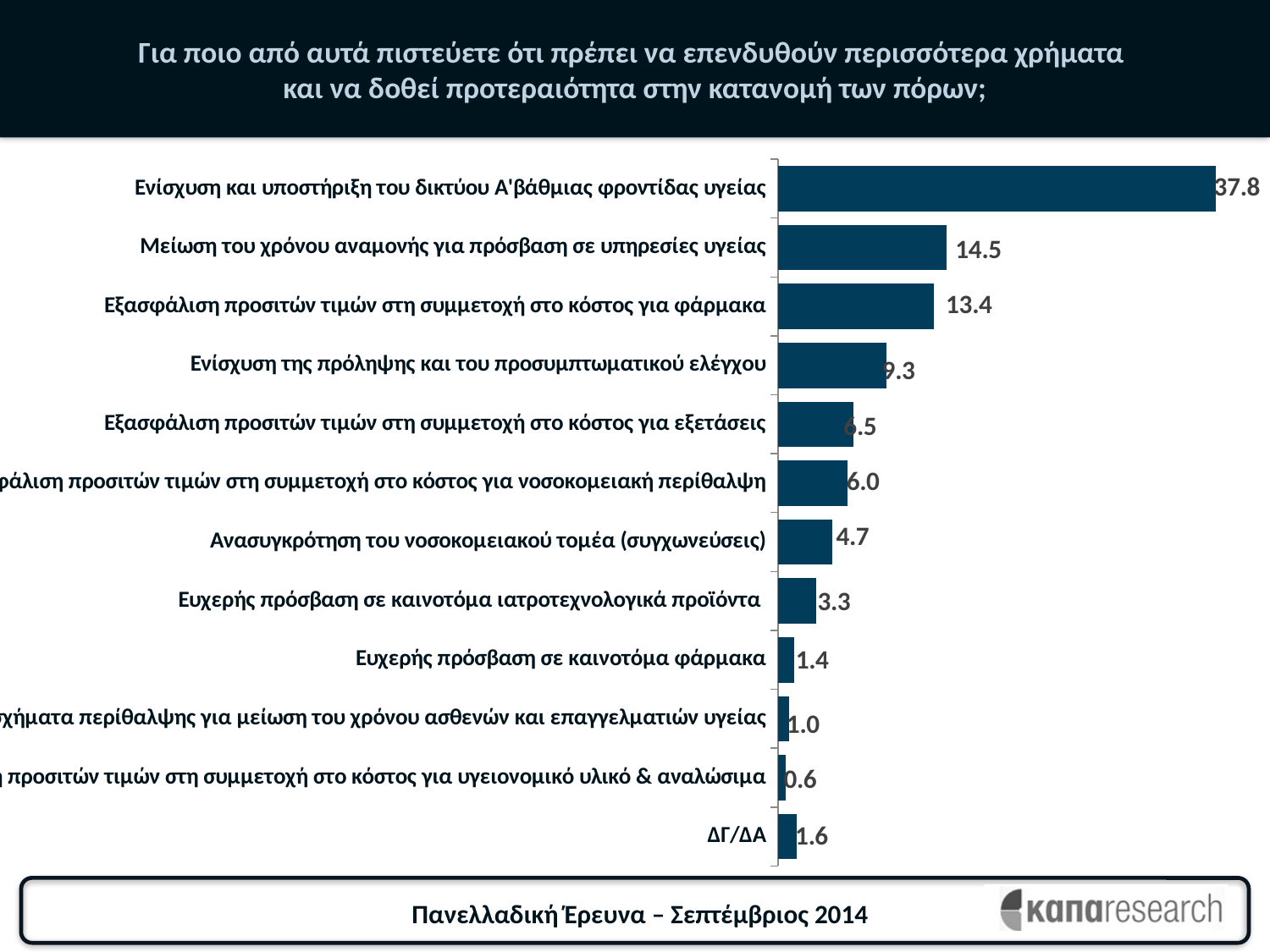
What is the value for "Ενίσχυση και υποστήριξη του δικτύου Α'βάθμιας φροντίδας υγείας"? 37.8 What kind of chart is shown on the slide? bar chart What is the smallest value shown on the chart? 0.6 How many bars are shown on the chart? 12 What is the difference between the values for "Μείωση του χρόνου αναμονής για πρόσβαση σε υπηρεσίες υγείας" and "Εξασφάλιση προσιτών τιμών στη συμμετοχή στο κόστος για φάρμακα"? 1.1 What is the value for "Ενίσχυση της πρόληψης και του προσυμπτωματικού ελέγχου"? 9.3 What is the value for "Μείωση του χρόνου αναμονής για πρόσβαση σε υπηρεσίες υγείας"? 14.5 What survey and date are stated at the bottom of the slide? Πανελλαδική Έρευνα – Σεπτέμβριος 2014 Which is larger: the value for "Ανασυγκρότηση του νοσοκομειακού τομέα (συγχωνεύσεις)" or for "Ευχερής πρόσβαση σε καινοτόμα ιατροτεχνολογικά προϊόντα"? Ανασυγκρότηση του νοσοκομειακού τομέα (συγχωνεύσεις) What is the difference between the highest value and the value for "Μείωση του χρόνου αναμονής για πρόσβαση σε υπηρεσίες υγείας"? 23.3 Which category has the highest value? Ενίσχυση και υποστήριξη του δικτύου Α'βάθμιας φροντίδας υγείας What is the value for "ΔΓ/ΔΑ"? 1.6